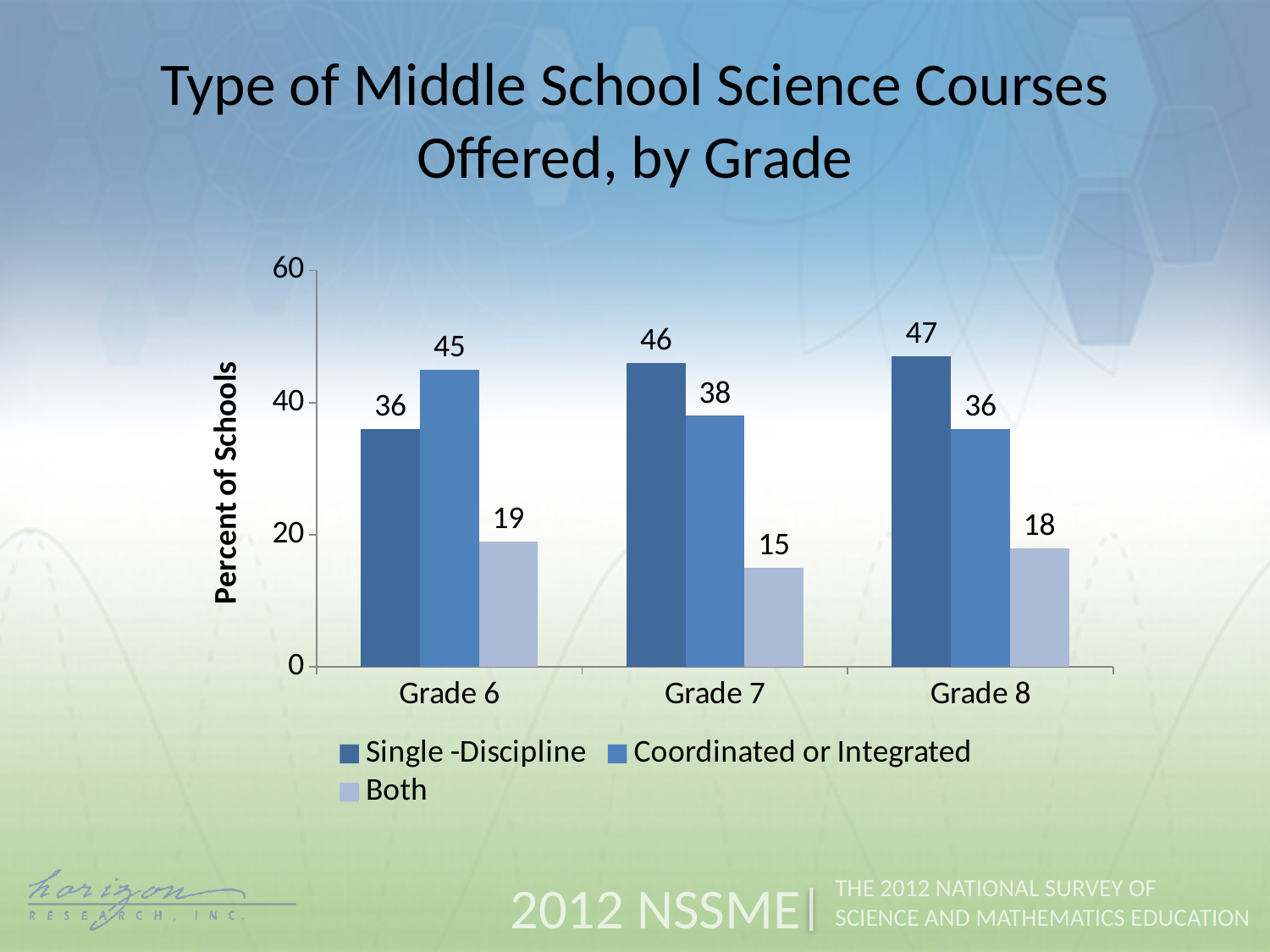
What kind of chart is shown on the slide? Bar chart How many grade categories are shown on the x axis? 3 Is the value for Both in Grade 6 greater or less than 20? less Which grade has the highest value for Single-Discipline courses? Grade 8 Which is larger in Grade 8: Single-Discipline or Coordinated or Integrated? Single-Discipline Which grade has the lowest value for Both? Grade 7 What is the value for Both in Grade 8? 18 How many series does the legend list? 3 What is the value for Coordinated or Integrated courses in Grade 7? 38 What is the value for Single-Discipline courses in Grade 6? 36 What is the label on the vertical axis? Percent of Schools What is the difference between the Coordinated or Integrated value and the Single-Discipline value in Grade 6? 9